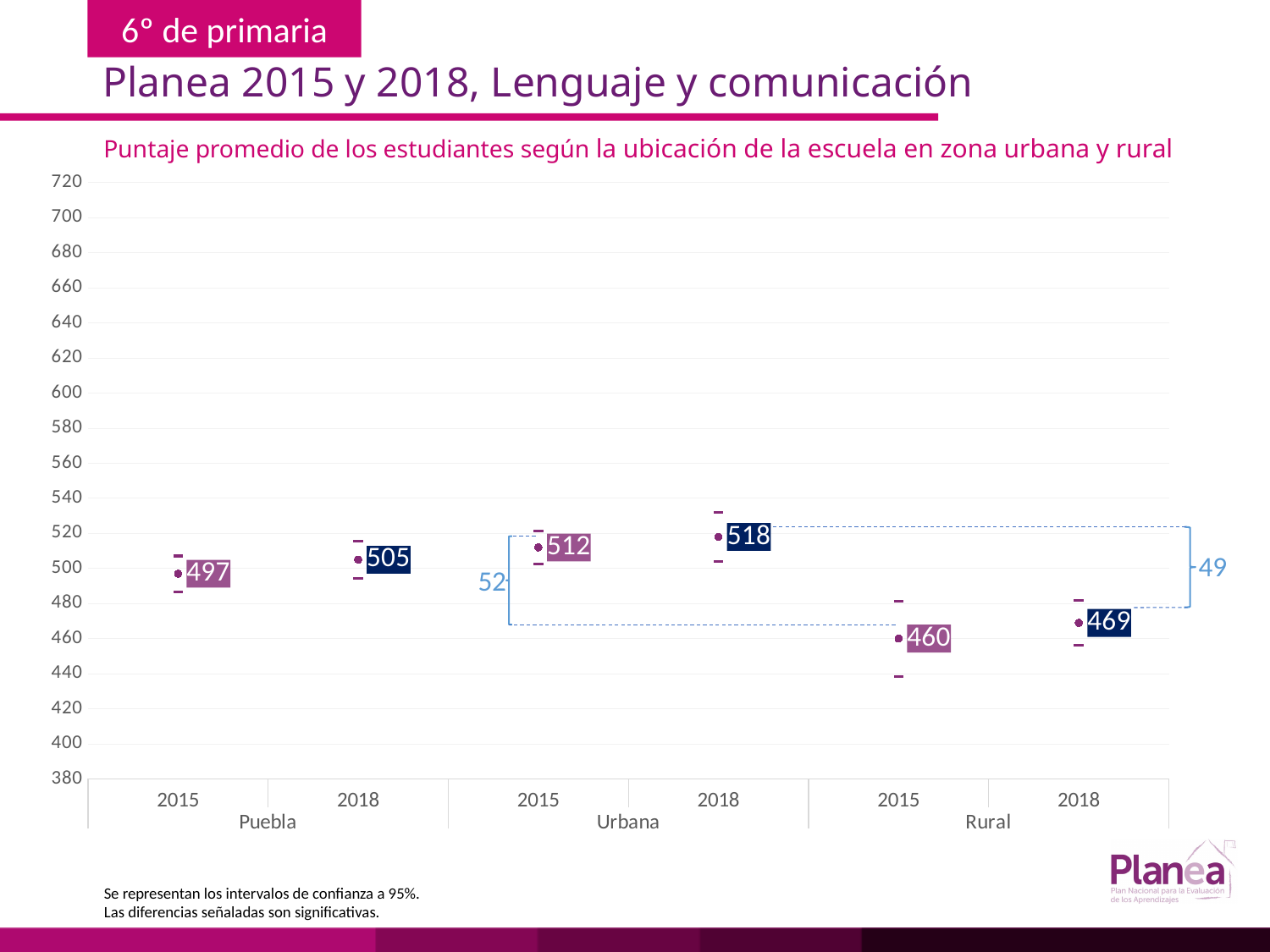
What is the average score for Urbana schools in 2018? 518 What is the subtitle of the chart? Puntaje promedio de los estudiantes según la ubicación de la escuela en zona urbana y rural What is the difference between the Urbana 2015 score and the Rural 2015 score? 52 Which group and year has the highest average score? Urbana 2018 What is the average score for Rural schools in 2015? 460 Which group and year has the lowest average score? Rural 2015 What is the difference between the Urbana 2018 score and the Rural 2018 score? 49 How many data points are plotted on the chart? 6 Which is larger, the Puebla 2018 score or the Rural 2018 score? Puebla 2018 What is the average score for Puebla in 2018? 505 Did the Rural average score rise or fall from 2015 to 2018? Rise What is the average score for Puebla in 2015? 497